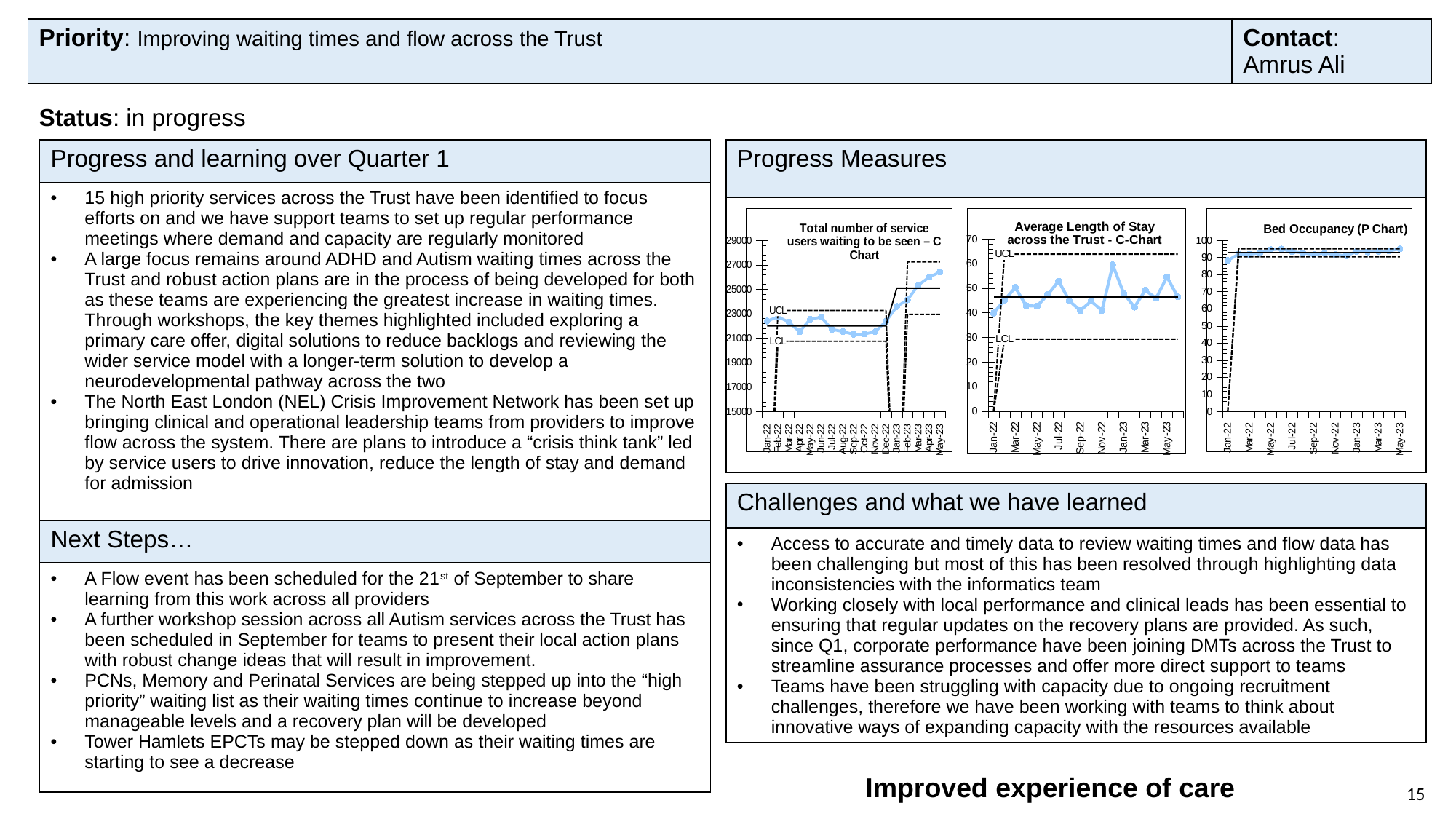
In the "Total number of service users waiting to be seen – C Chart", is the value for Jan-22 greater or less than 19000? greater In the "Total number of service users waiting to be seen – C Chart", is the value for May-23 greater or less than 25000? greater In the "Bed Occupancy (P Chart)", is the value for May-23 greater or less than 80? greater What kind of chart is the "Total number of service users waiting to be seen – C Chart"? line chart In the "Total number of service users waiting to be seen – C Chart", do the values overall rise or fall from Jan-22 to May-23? rise What is the title of the rightmost chart in the Progress Measures section? Bed Occupancy (P Chart) What are the two dashed control limit lines in the "Average Length of Stay across the Trust - C-Chart" labelled? UCL and LCL How many charts are shown in the Progress Measures section? 3 In the "Total number of service users waiting to be seen – C Chart", which is larger, the value for Jan-22 or the value for May-23? May-23 In the "Average Length of Stay across the Trust - C-Chart", which month has the highest value? Dec-22